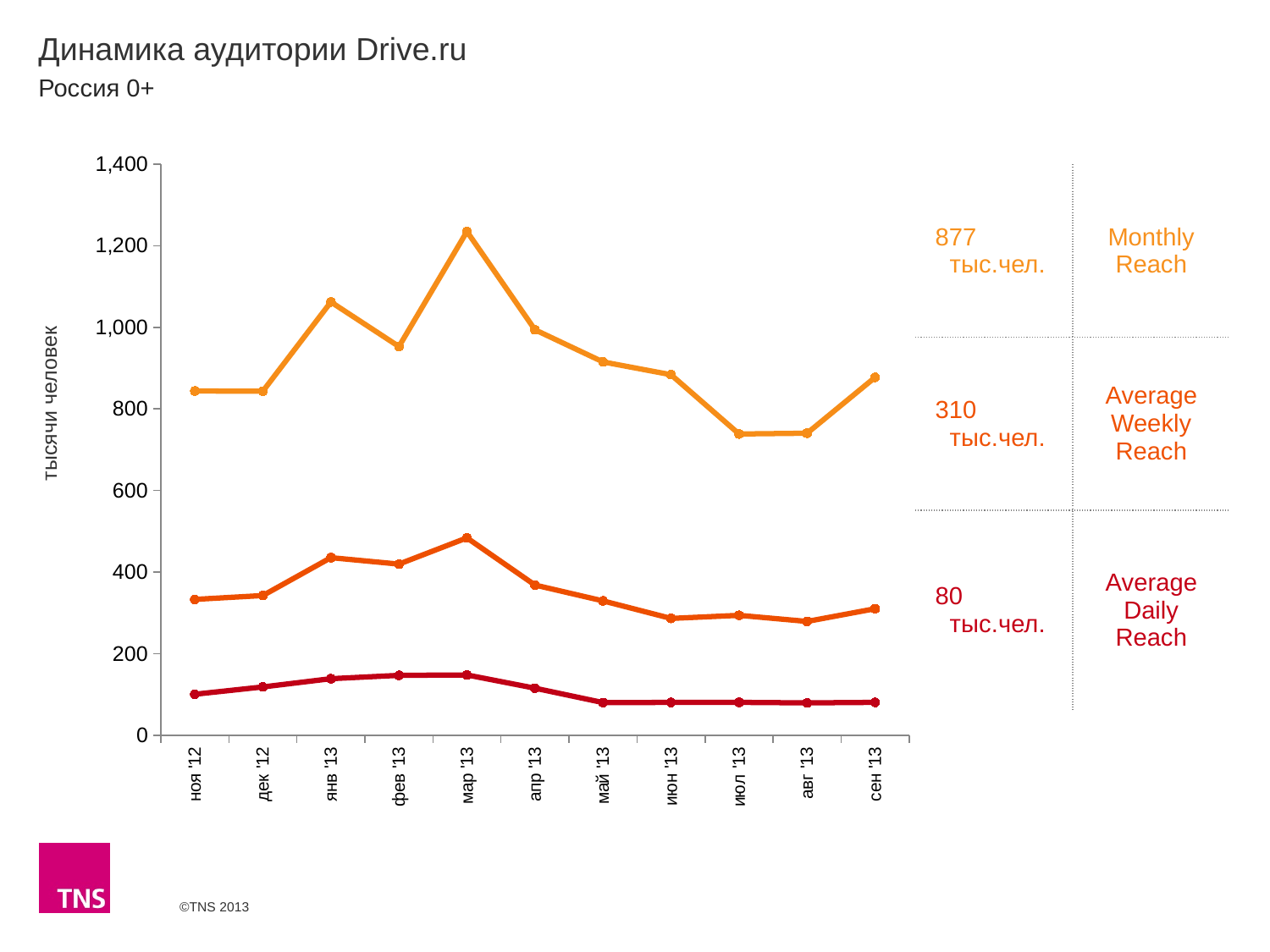
Which month has the higher Monthly Reach, янв '13 or фев '13? янв '13 What Monthly Reach value is printed on the slide? 877 тыс.чел. How many months are plotted along the x axis of the chart? 11 Is the Average Daily Reach value for мар '13 greater or less than 200? less Is the Average Weekly Reach value for мар '13 greater or less than 400? greater Is the Monthly Reach value for янв '13 greater or less than 1,000? greater Does the Monthly Reach line rise or fall from мар '13 to авг '13? fall In which month does the Monthly Reach line reach its highest point? мар '13 How many series are plotted on the chart? 3 What kind of chart is shown on the slide? line chart What is the label on the vertical axis of the chart? тысячи человек